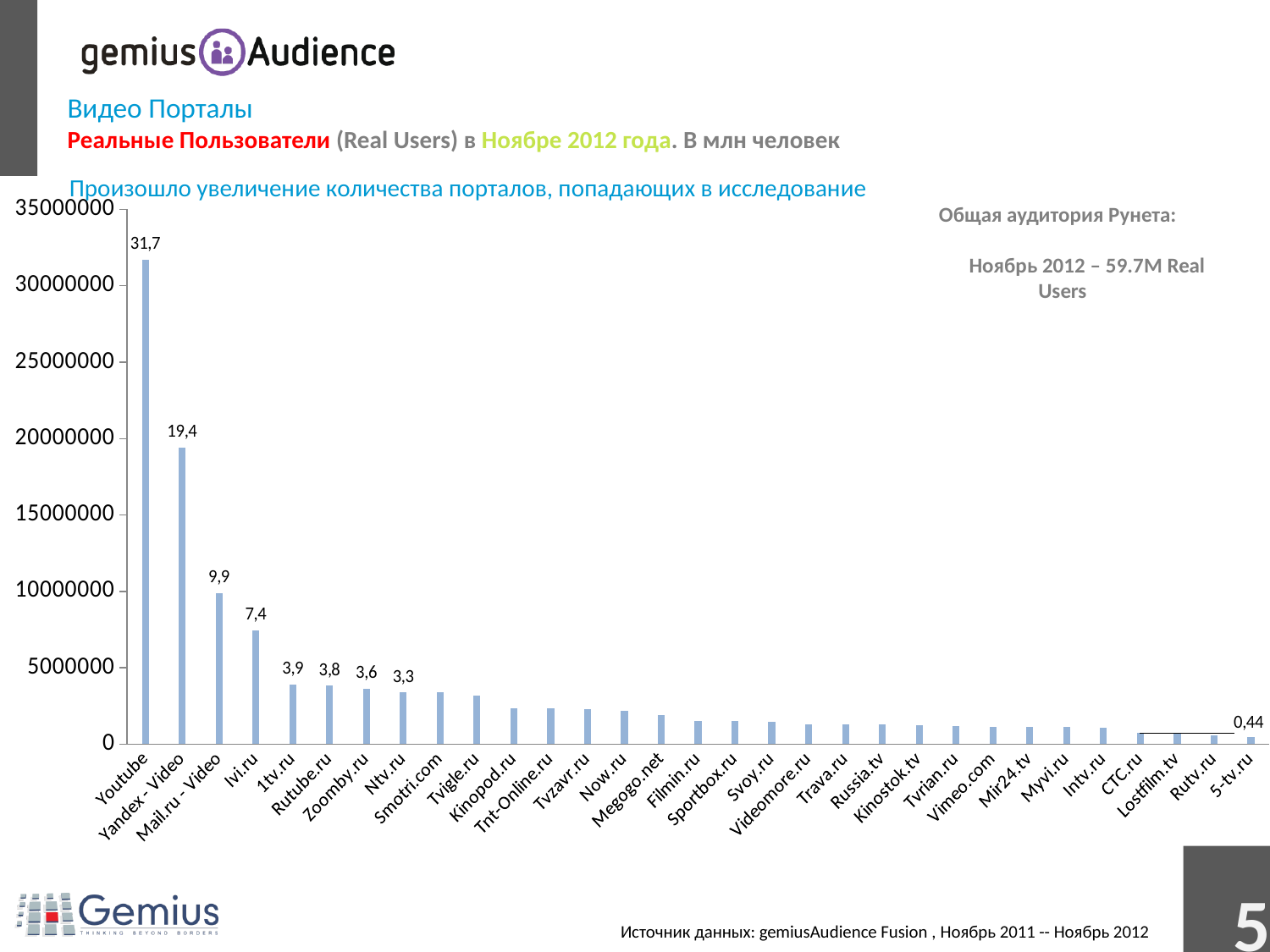
Which is larger, the value for Mail.ru - Video or the value for Ivi.ru? Mail.ru - Video Do the values rise or fall moving from left to right along the x axis? fall What kind of chart is shown on the slide? bar chart What is the difference between the labelled values for Youtube and Yandex - Video? 12,3 How many portals are shown on the x axis of the chart? 31 What is the value shown for Youtube? 31,7 What is the value shown for Yandex - Video? 19,4 Which portal has the lowest value in the chart? 5-tv.ru What is the value shown for 5-tv.ru? 0,44 What is the value shown for Ivi.ru? 7,4 Which portal has the highest value in the chart? Youtube Is the value for Smotri.com greater or less than 5000000? less